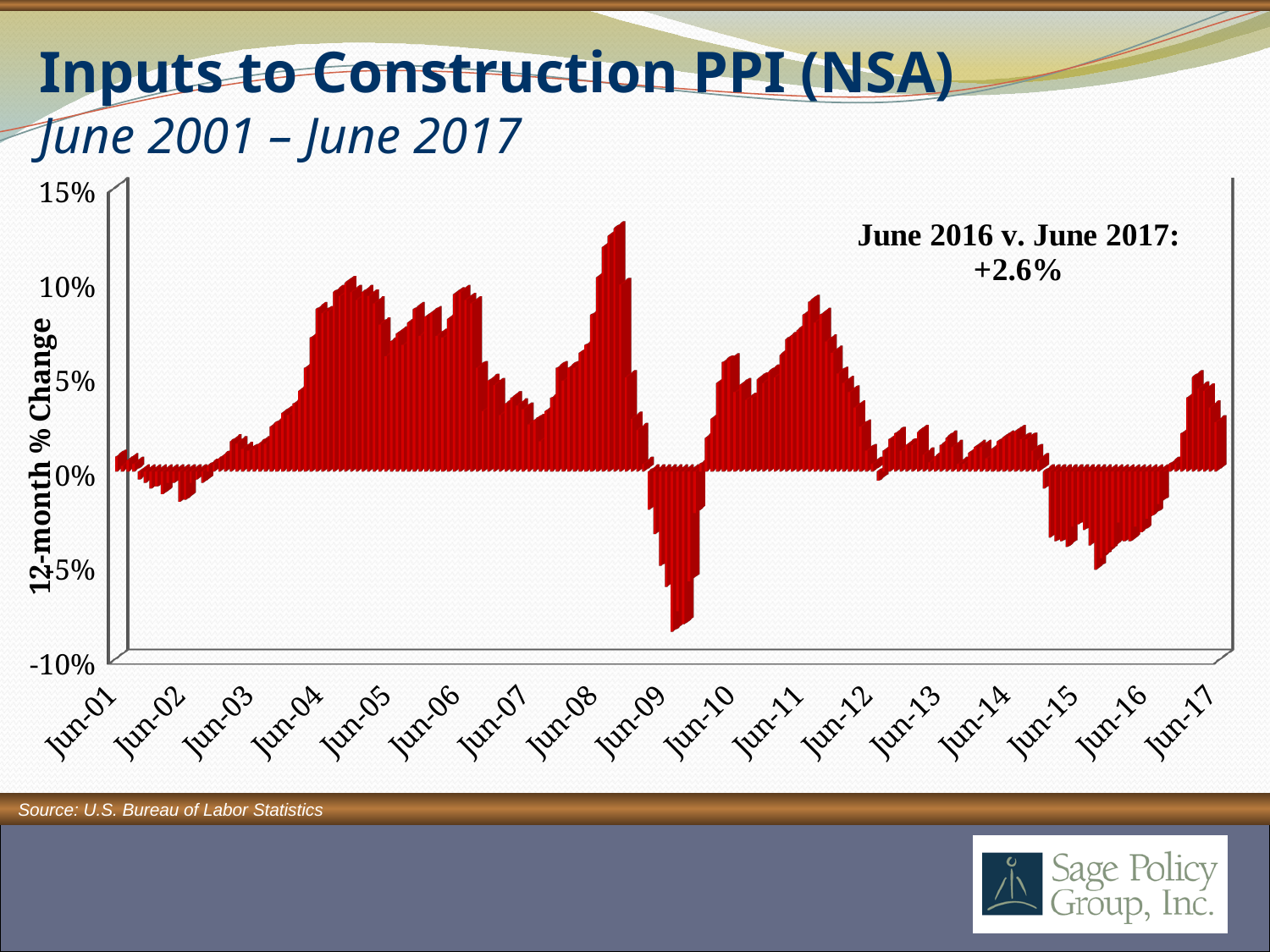
What kind of chart is shown on the slide? bar chart Is the value around Jun-15 greater or less than 0%? less According to the annotation on the chart, what is the change from June 2016 to June 2017? +2.6% Is the value around Jun-11 greater or less than 5%? greater How many year labels are shown on the horizontal axis? 17 Is the lowest value on the chart, reached around Jun-09, greater or less than -5%? less What is the label on the vertical axis of the chart? 12-month % Change Do the values rise or fall between Jun-16 and Jun-17? rise What is the title of the chart on the slide? Inputs to Construction PPI (NSA) Do the values rise or fall between Jun-08 and Jun-09? fall